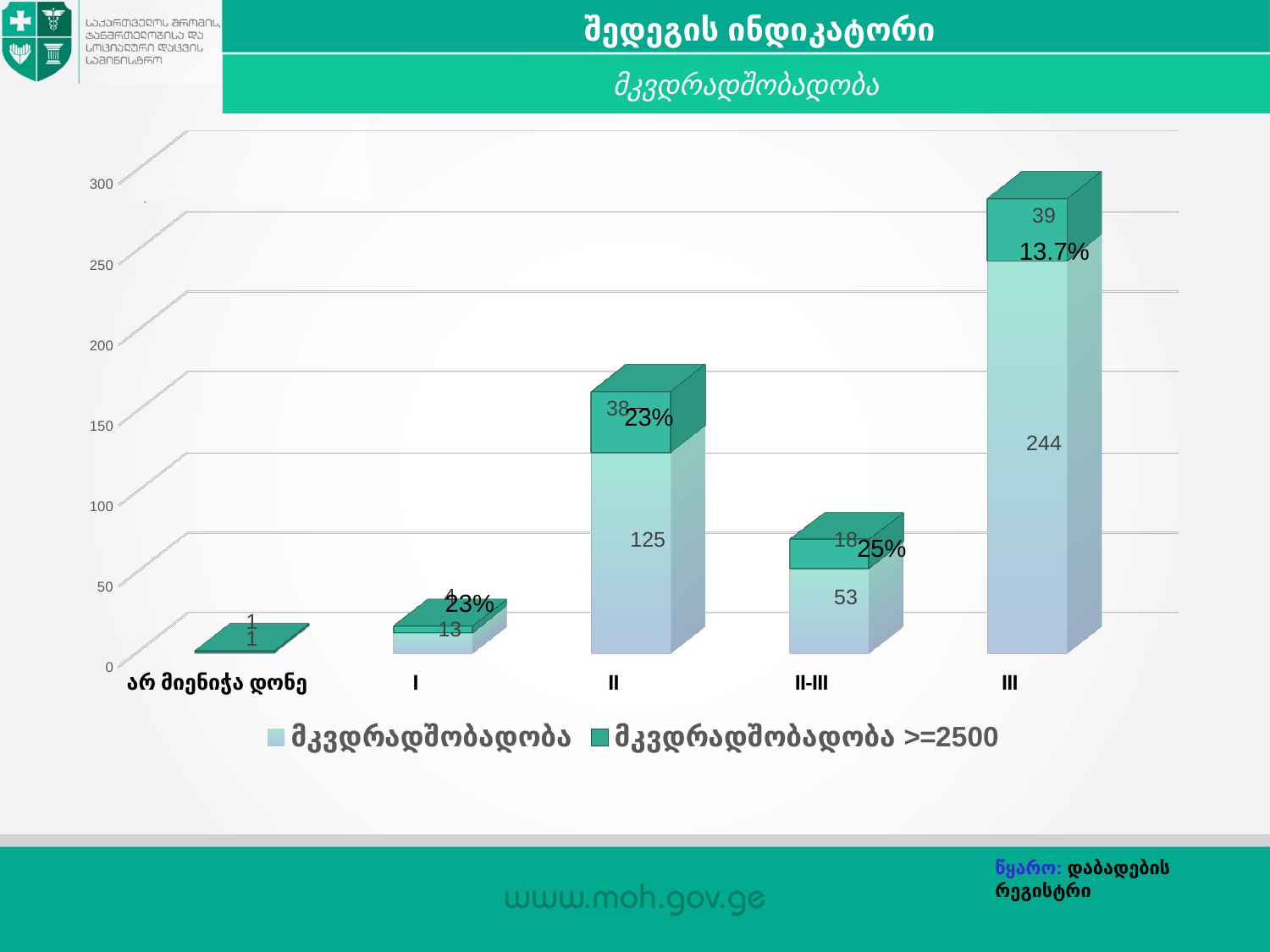
What is the difference between the მკვდრადშობადობა values for categories III and II? 119 What percentage label is shown on the bar for category III? 13.7% How many series does the legend list? 2 What is the value of the მკვდრადშობადობა >=2500 series for category I? 4 Which category has the lowest value for the მკვდრადშობადობა >=2500 series? არ მიენიჭა დონე What is the value of the მკვდრადშობადობა series for category III? 244 Which category has the highest value for the მკვდრადშობადობა series? III What is the value of the მკვდრადშობადობა series for category II-III? 53 How many categories are shown on the x axis? 5 Which is larger: the მკვდრადშობადობა >=2500 value for category II or for category III? III What is the value of the მკვდრადშობადობა >=2500 series for category II? 38 What is the total of the stacked bar for category II? 163